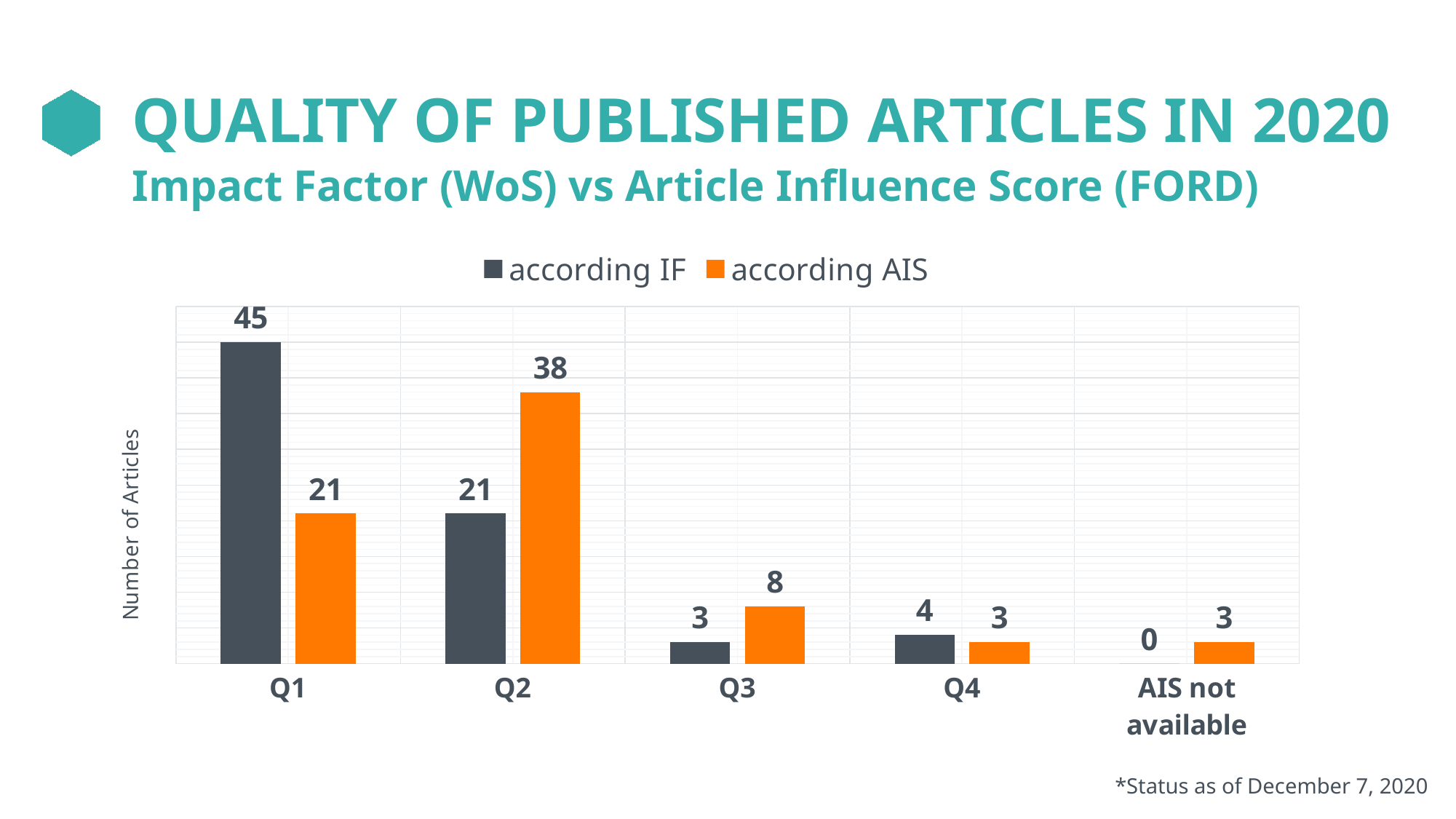
What kind of chart is shown on the slide? bar chart What is the number of articles in Q3 according AIS? 8 Which category has the highest value according IF? Q1 What is the difference between the according AIS and according IF values for Q2? 17 What is the value for 'AIS not available' according IF? 0 How many categories are shown on the x axis? 5 How many series does the legend list? 2 What is the number of articles in Q1 according IF? 45 What is the difference between the according IF and according AIS values for Q1? 24 For Q3, which series has the larger value, according IF or according AIS? according AIS What is the number of articles in Q2 according AIS? 38